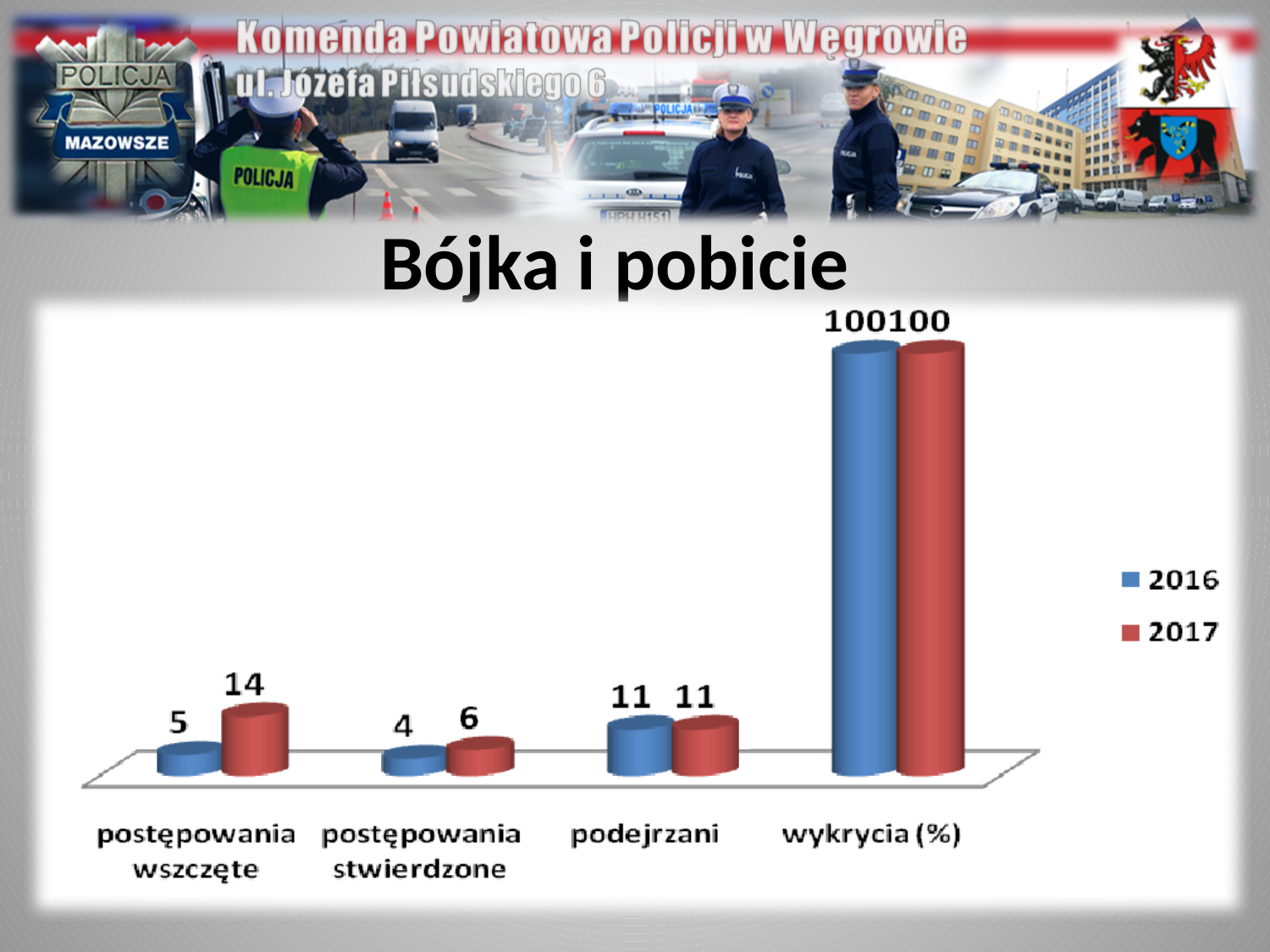
How many series does the legend list? 2 Which category has the highest value for 2017? wykrycia (%) What is the value for 2017 in the 'wykrycia (%)' category? 100 What is the value for 2017 in the 'podejrzani' category? 11 How many categories are shown on the x axis? 4 Which is larger for 'postępowania stwierdzone': the 2016 value or the 2017 value? 2017 What is the difference between the 2017 and 2016 values for 'postępowania wszczęte'? 9 Which category has the lowest value for 2016? postępowania stwierdzone What is the value for 2016 in the 'postępowania stwierdzone' category? 4 What kind of chart is shown on the slide? bar chart What is the value for 2017 in the 'postępowania wszczęte' category? 14 What is the value for 2016 in the 'postępowania wszczęte' category? 5